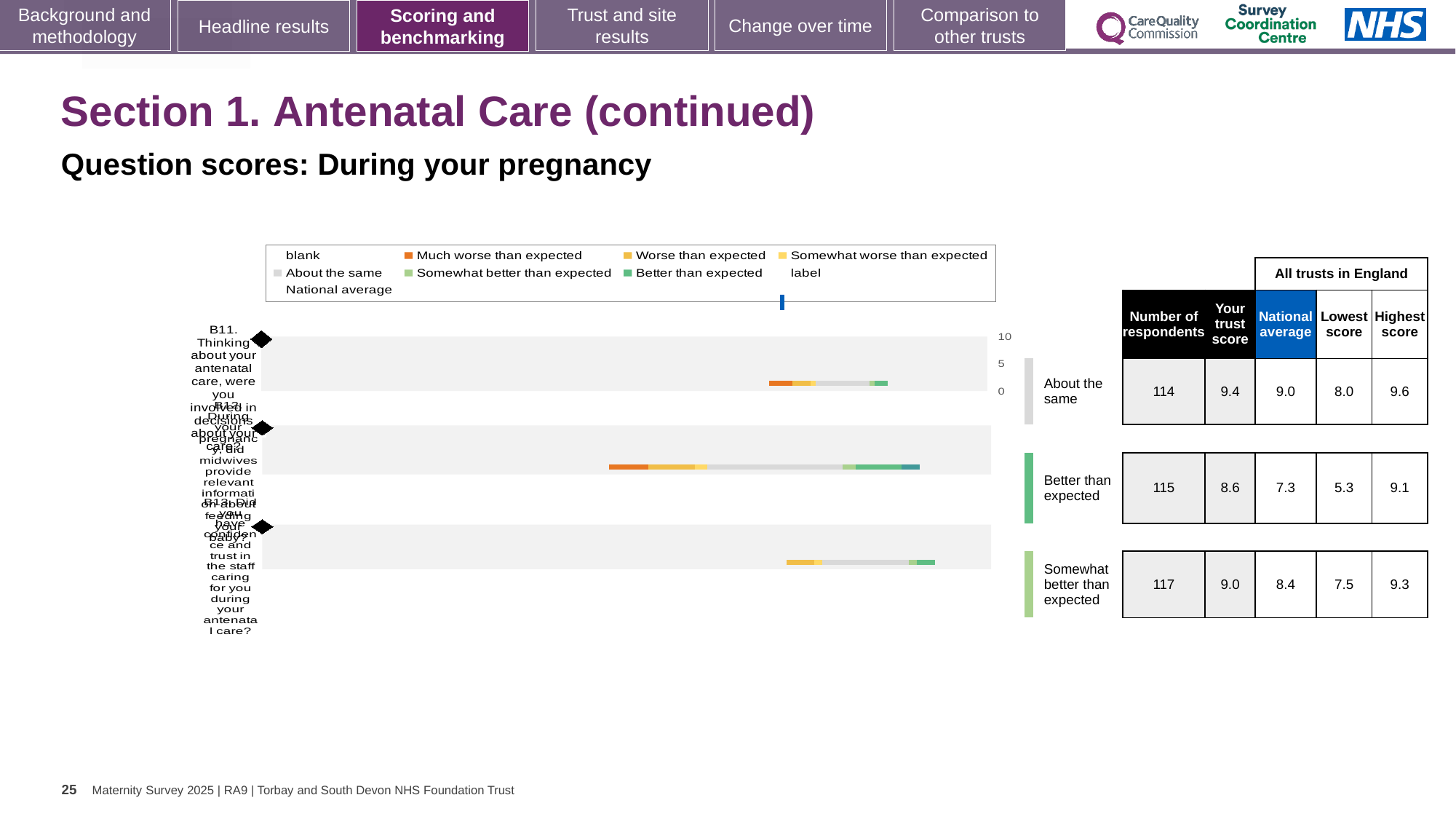
What is the highest value shown on the chart's numeric axis? 10 What kind of chart is shown on the slide? bar chart How many entries does the chart's legend list? 9 Which colour represents 'Much worse than expected' in the chart legend? orange What is the label of the first (top) category on the chart? B11. Thinking about your antenatal care, were you involved in decisions about your care? How many questions (categories) are plotted on the chart? 3